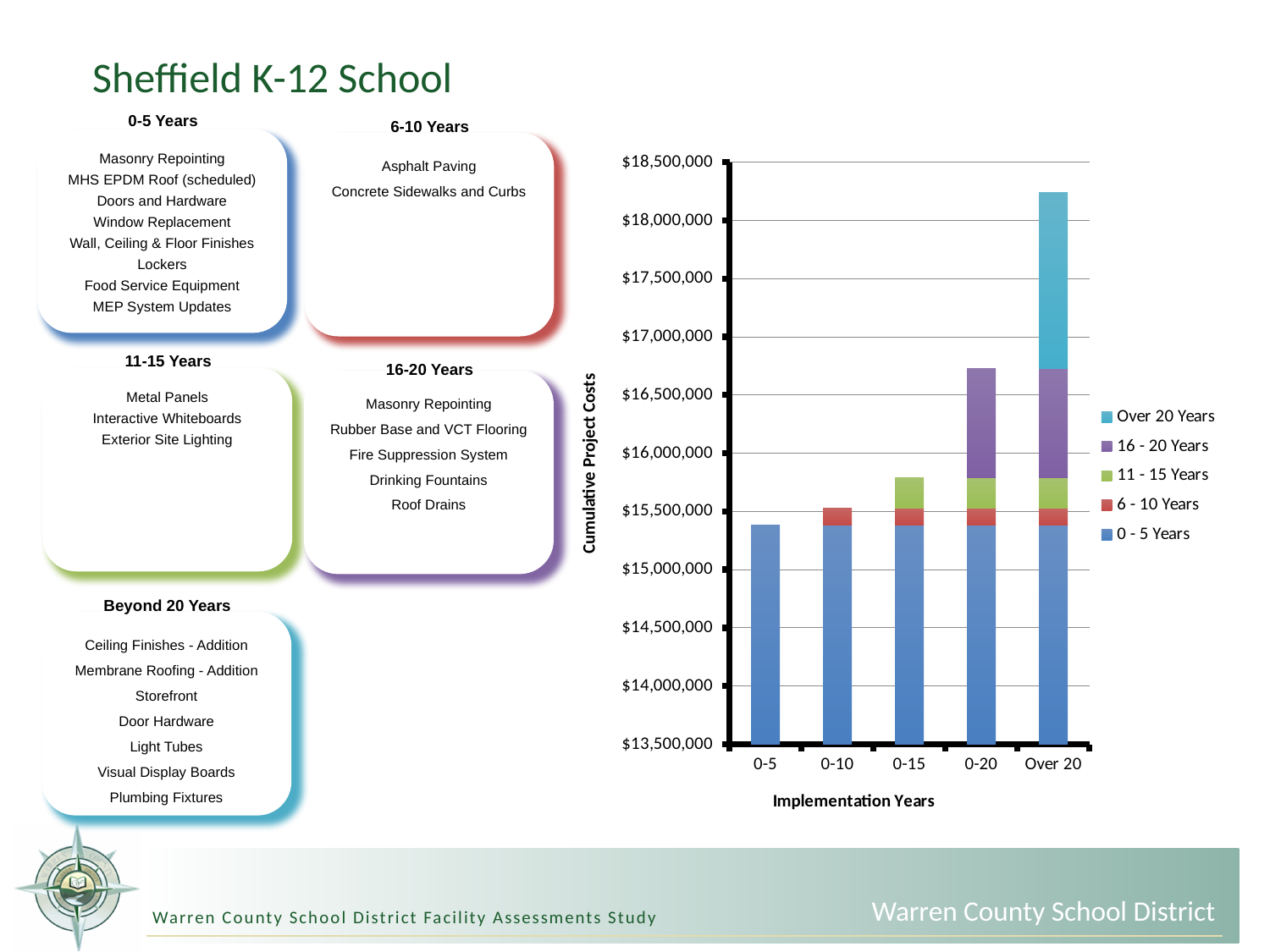
Is the total cumulative project cost for 0-20 greater or less than $16,500,000? greater Which implementation-year category has the lowest cumulative project cost? 0-5 Do the cumulative project costs rise or fall from 0-5 to Over 20 along the x axis? Rise What kind of chart is shown on the slide? Stacked bar chart How many implementation-year categories are shown on the x axis? 5 What is the title of the vertical axis of the chart? Cumulative Project Costs Which implementation-year category has the highest cumulative project cost? Over 20 How many series does the legend list? 5 Is the total cumulative project cost for 0-15 greater or less than $16,000,000? less Is the cumulative project cost for 0-5 greater or less than $15,500,000? less Which has the larger total cumulative project cost, 0-10 or 0-20? 0-20